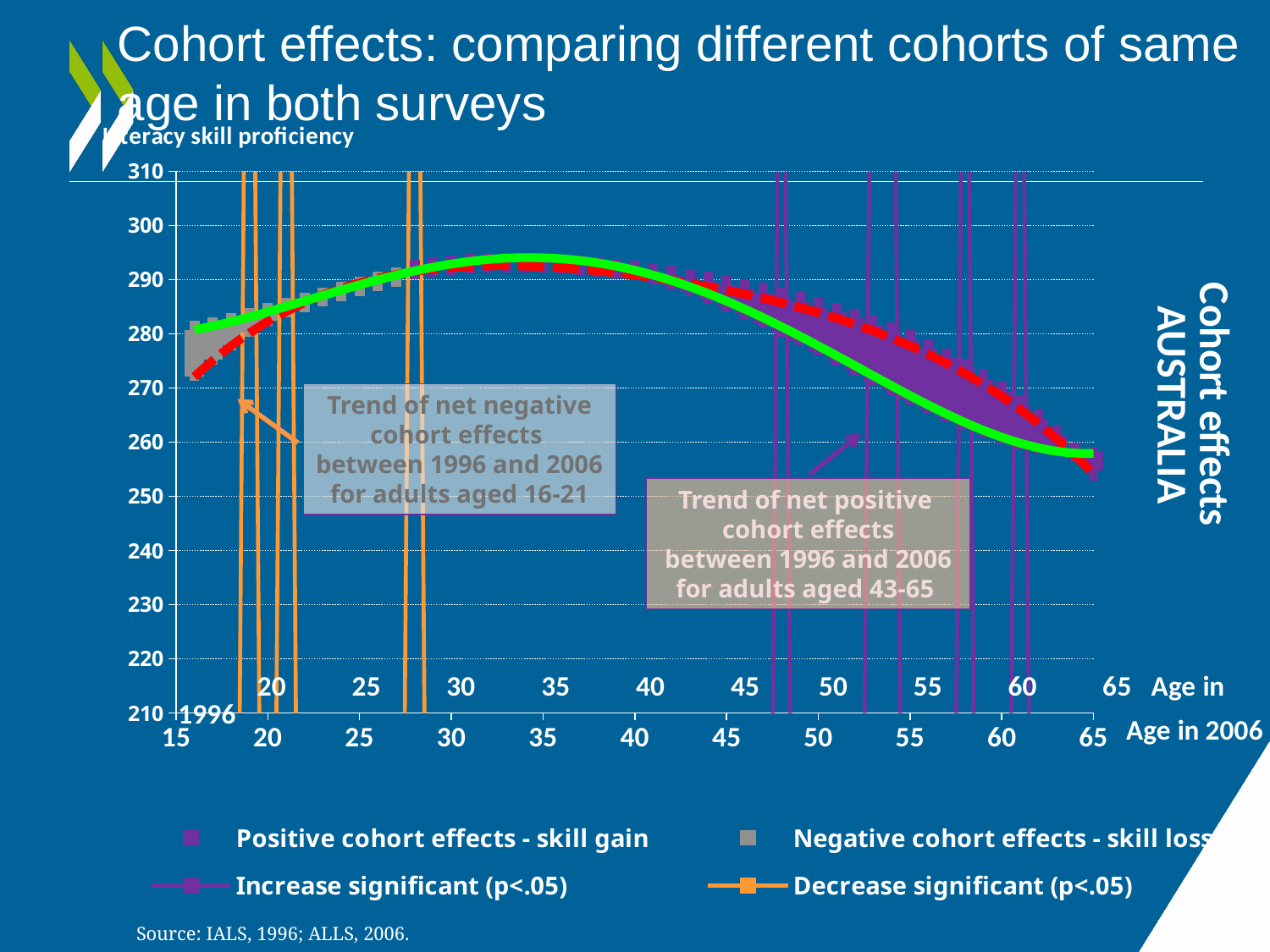
How many entries does the legend list? 4 Is the value of the red dashed line at age 16 greater or less than 280? less Do the plotted values rise or fall along the x axis between age 40 and age 65? fall Is the value of the green line at age 60 greater or less than 270? less Is the value of the red dashed line at age 60 greater or less than 280? less What kind of chart is shown on the slide? line chart Which line is higher at age 55, the green line or the red dashed line? the red dashed line What is the title printed on the right side of the chart? Cohort effects AUSTRALIA What does the y axis of the chart measure? Literacy skill proficiency Do the plotted values rise or fall along the x axis between age 16 and age 30? rise